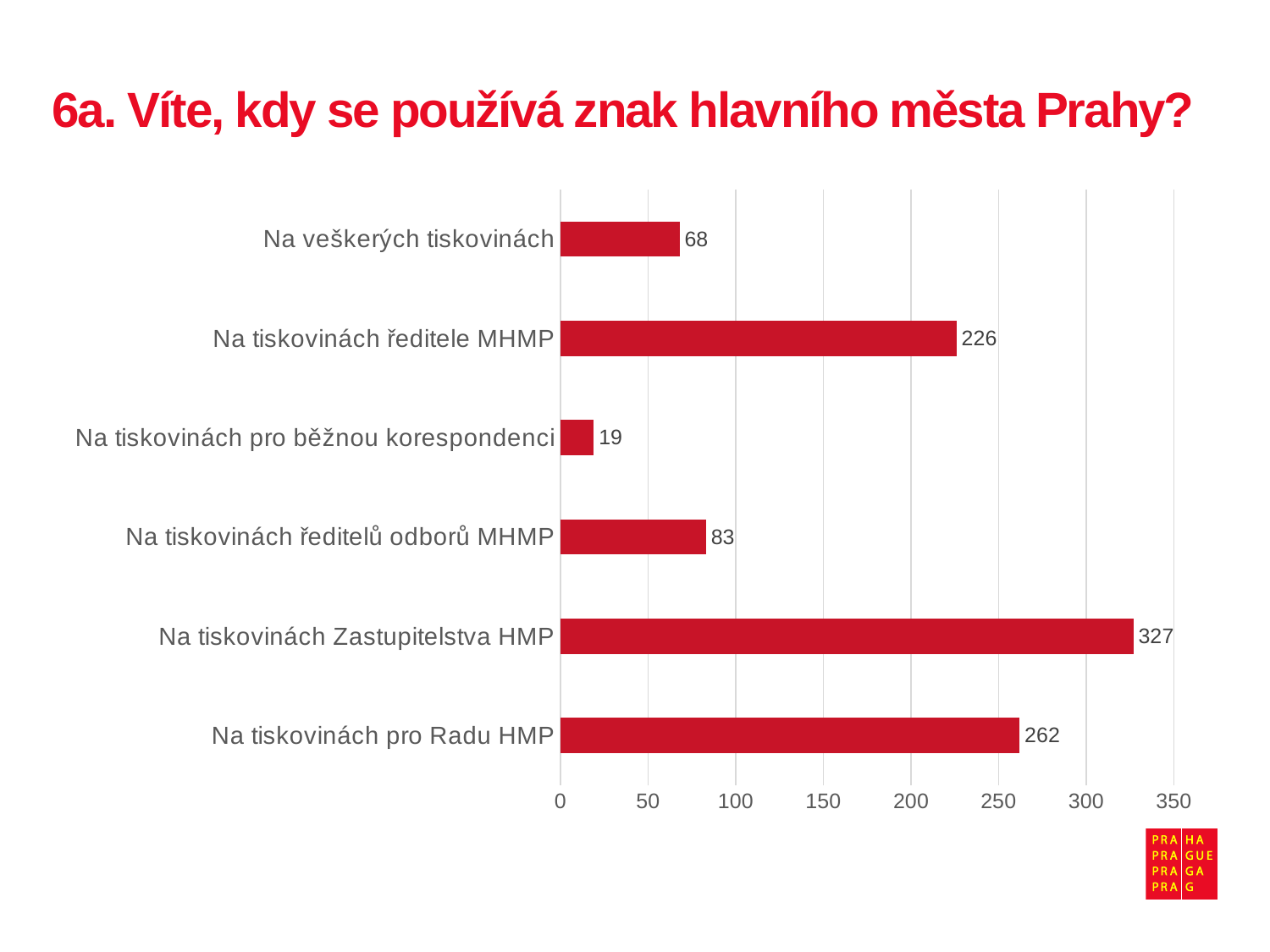
Which is larger: the value for 'Na tiskovinách ředitele MHMP' or 'Na tiskovinách pro Radu HMP'? Na tiskovinách pro Radu HMP What is the value for 'Na veškerých tiskovinách'? 68 What is the value for 'Na tiskovinách ředitele MHMP'? 226 Is the value for 'Na tiskovinách ředitele MHMP' greater or less than 200? greater What is the difference between the values for 'Na tiskovinách ředitelů odborů MHMP' and 'Na veškerých tiskovinách'? 15 What kind of chart is shown on the slide? bar chart What is the difference between the values for 'Na tiskovinách Zastupitelstva HMP' and 'Na tiskovinách pro Radu HMP'? 65 What is the value for 'Na tiskovinách Zastupitelstva HMP'? 327 How many categories are shown in the chart? 6 Which category has the highest value? Na tiskovinách Zastupitelstva HMP What is the value for 'Na tiskovinách pro běžnou korespondenci'? 19 Which category has the lowest value? Na tiskovinách pro běžnou korespondenci